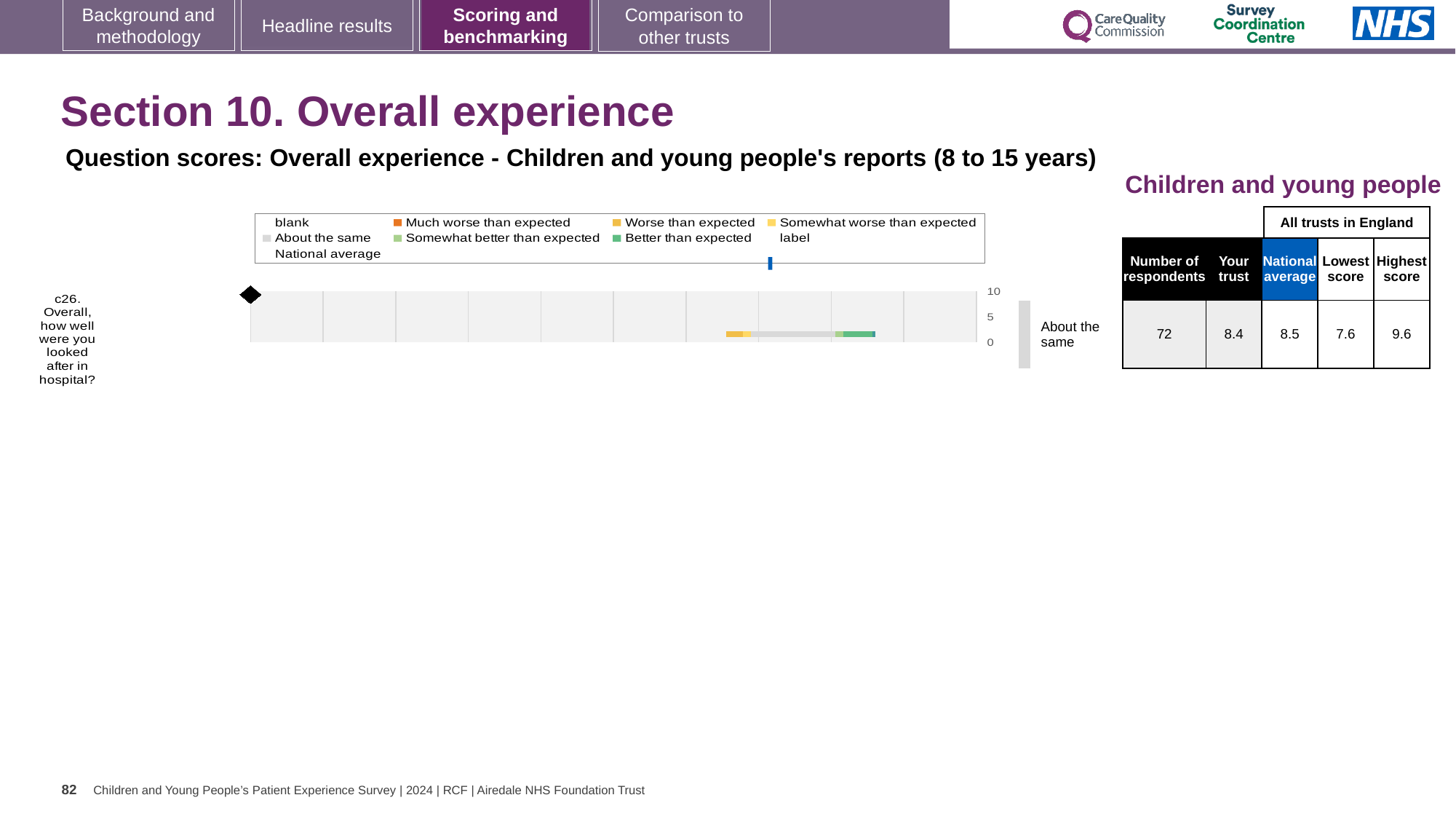
How many respondents answered question c26? 72 What is the national average score for question c26? 8.5 What kind of chart is used to show the score for question c26? bar chart What is the highest score among all trusts in England for question c26? 9.6 What is the difference between the highest score and the lowest score for question c26? 2.0 Which is larger for question c26, the 'Your trust' score or the national average? National average Is the trust's score for question c26 greater or less than 5 on the chart axis? greater What is the 'Your trust' score for question c26? 8.4 Which benchmark category is the trust's result for question c26 placed in? About the same What is the lowest score among all trusts in England for question c26? 7.6 Which question is plotted on the chart? c26. Overall, how well were you looked after in hospital? How many survey questions are plotted on the chart? 1